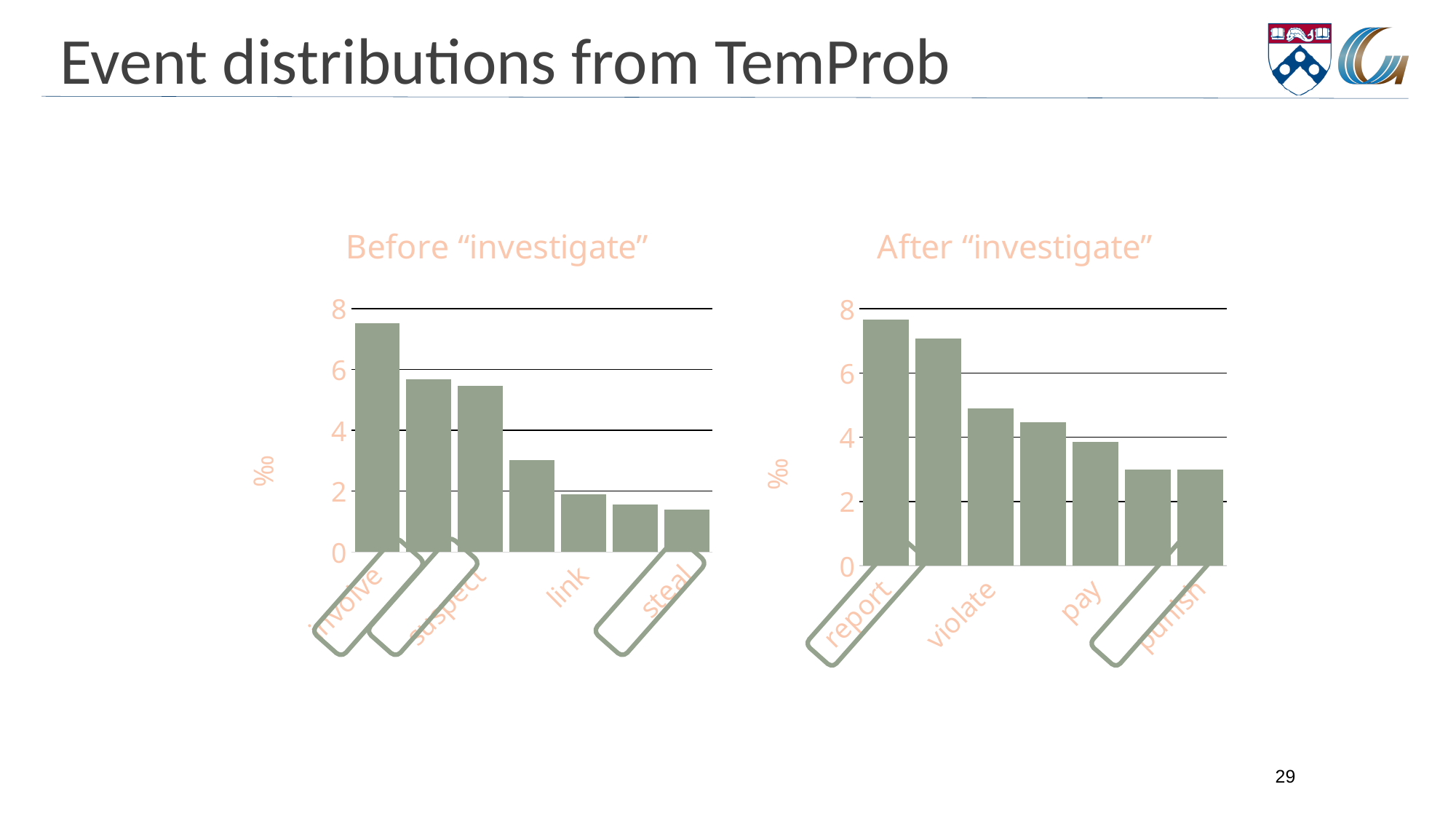
In the "Before "investigate"" chart, which event has the highest value? involve In the "After "investigate"" chart, which event has the highest value? report In the "After "investigate"" chart, is the value for punish greater or less than 2? greater In the "After "investigate"" chart, is the value for violate greater or less than 6? less In the "Before "investigate"" chart, is the value for involve greater or less than 6? greater Do the values in the "After "investigate"" chart rise or fall from left to right? fall How many bars does the "Before "investigate"" chart have? 7 What kind of chart is the "Before "investigate"" chart? bar chart How many bars does the "After "investigate"" chart have? 7 In the "After "investigate"" chart, which is larger, the value for report or the value for pay? report